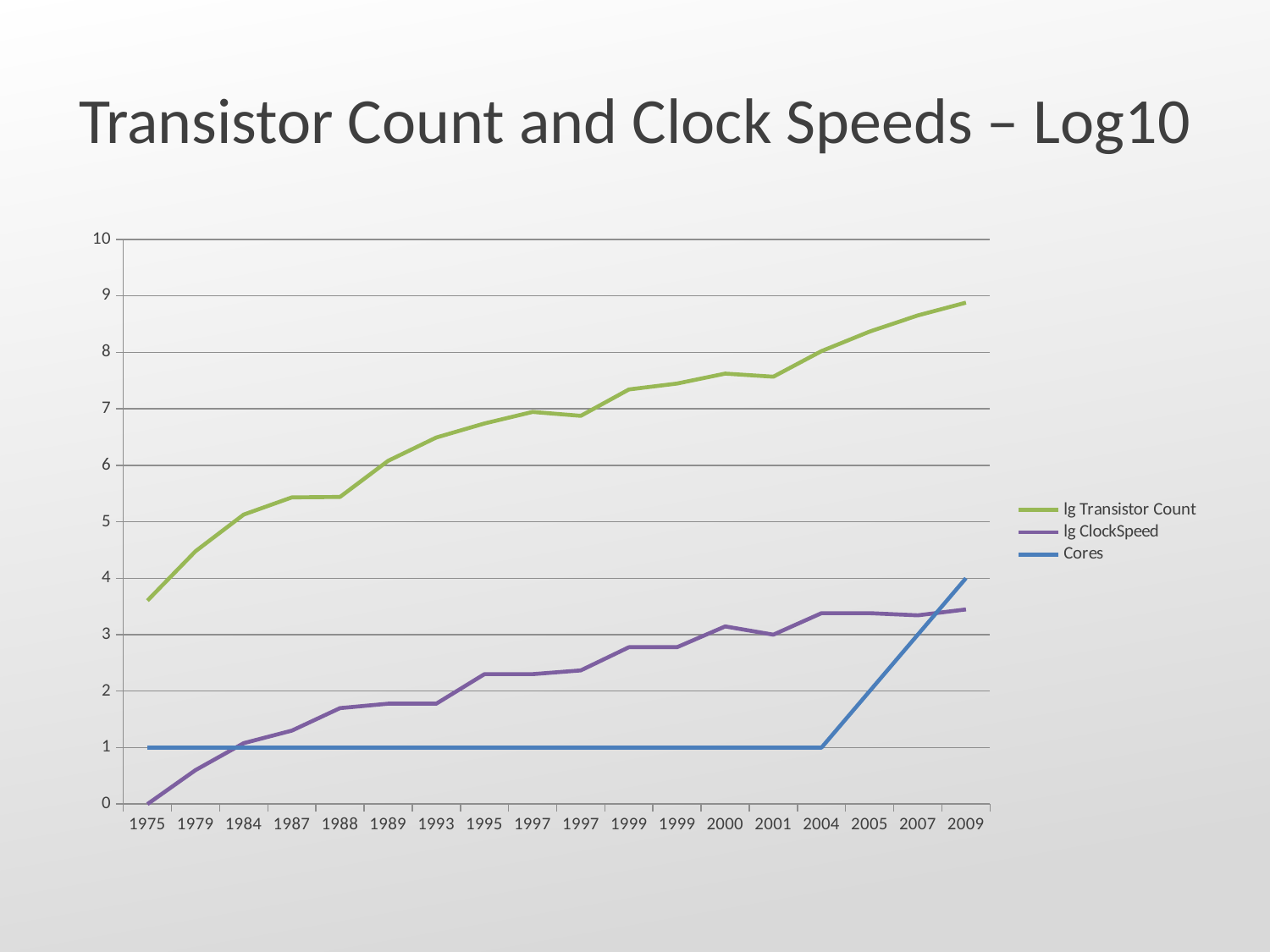
Is the value of lg Transistor Count in 1975 greater or less than 4? less Is the value of lg Transistor Count in 2009 greater or less than 8? greater How many series does the legend list? 3 What type of chart is shown on the slide? line chart What is the value of lg ClockSpeed in 1975? 0 What is the value of Cores in 2009? 4 What is the value of Cores in 1975? 1 Is the value of lg ClockSpeed in 1995 greater or less than 2? greater Does lg Transistor Count generally rise or fall from 1975 to 2009? rise In which year is lg Transistor Count highest? 2009 What is the title of the chart? Transistor Count and Clock Speeds – Log10 How many points are plotted along the x axis for each series? 18